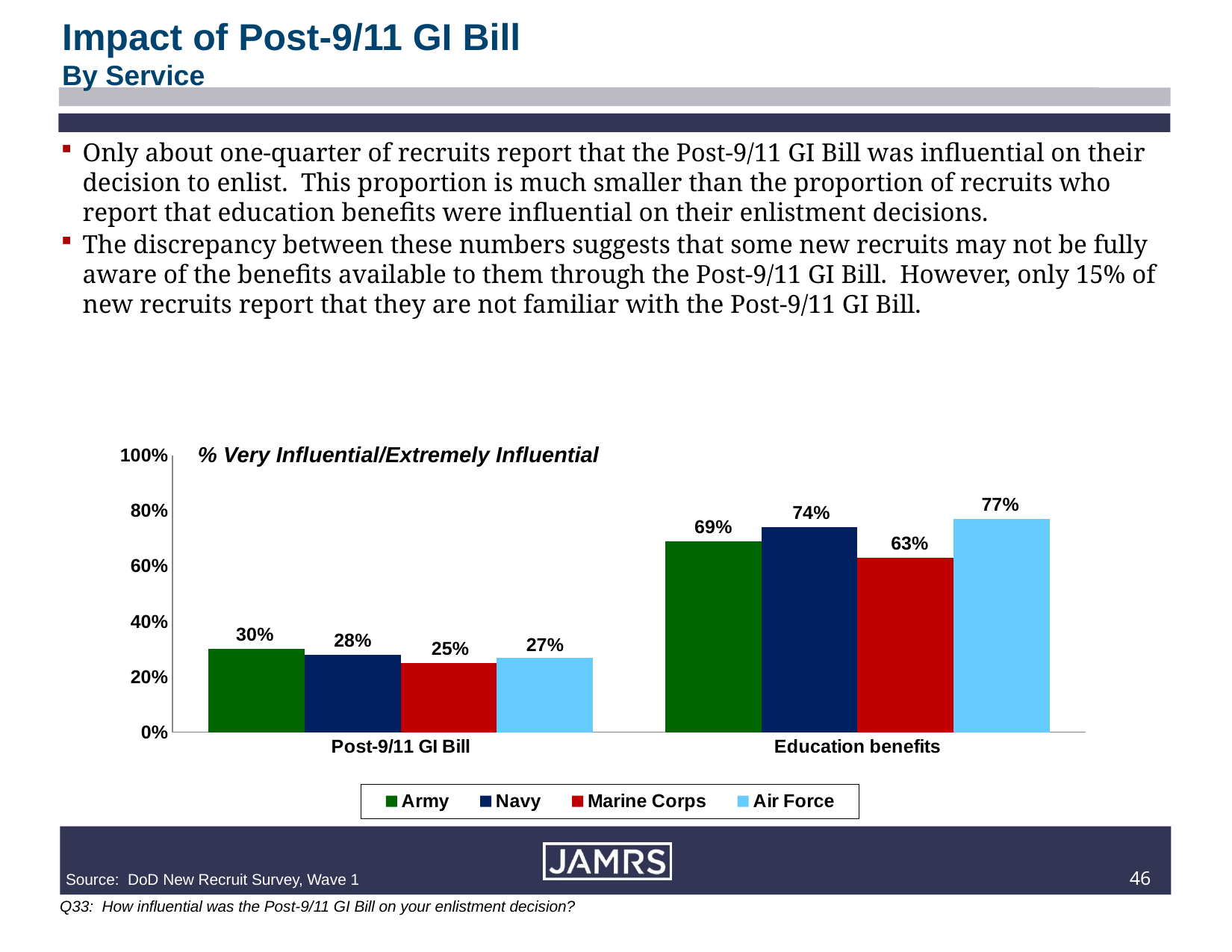
How many series does the legend list? 4 Which service has the highest value for Education benefits? Air Force How many categories are shown on the x axis? 2 What kind of chart is shown on the slide? Bar chart Is the Army's value for Education benefits greater or less than 60%? greater Which service has the lowest value for the Post-9/11 GI Bill? Marine Corps What is the difference between the Navy's Education benefits value and its Post-9/11 GI Bill value? 46% What colour represents the Navy in the chart? Dark blue Which is larger for the Marine Corps: the Post-9/11 GI Bill value or the Education benefits value? Education benefits What is the value for Marine Corps in the Post-9/11 GI Bill category? 25% What is the value for Air Force in the Education benefits category? 77% What percentage of Army recruits rated the Post-9/11 GI Bill as very or extremely influential? 30%